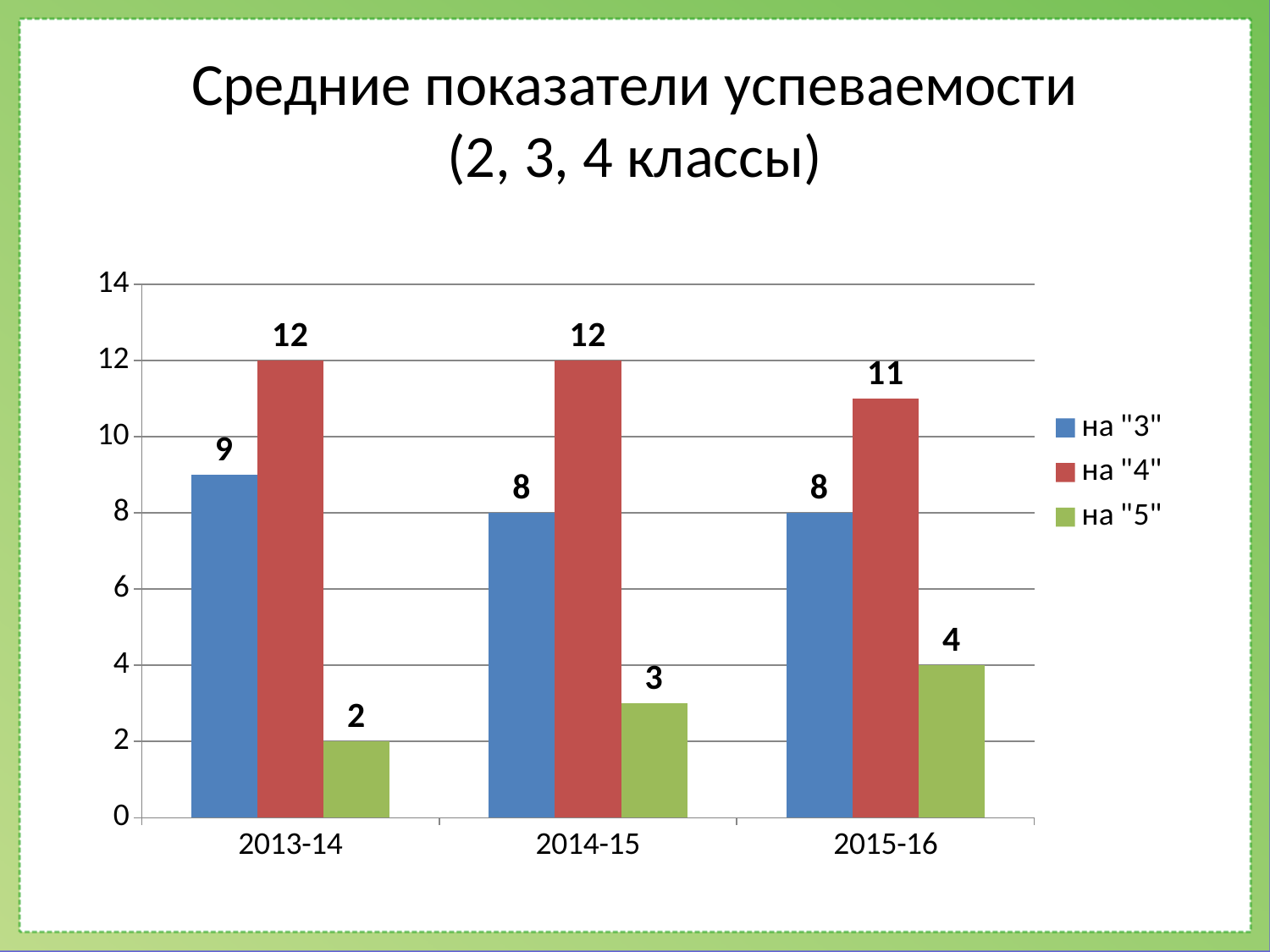
What is the value for на "4" in 2013-14? 12 What kind of chart is shown on the slide? bar chart Is the value for на "4" in 2015-16 greater or less than 10? greater What is the value for на "3" in 2014-15? 8 Which year has the highest value for на "5"? 2015-16 What is the difference between на "4" and на "3" in 2015-16? 3 Which year has the lowest value for на "3"? 2014-15 and 2015-16 (both 8) Which is larger in 2013-14: на "3" or на "5"? на "3" Does the value for на "5" rise or fall from 2013-14 to 2015-16? rise How many series does the legend list? 3 What is the value for на "5" in 2015-16? 4 How many years are shown on the x axis? 3